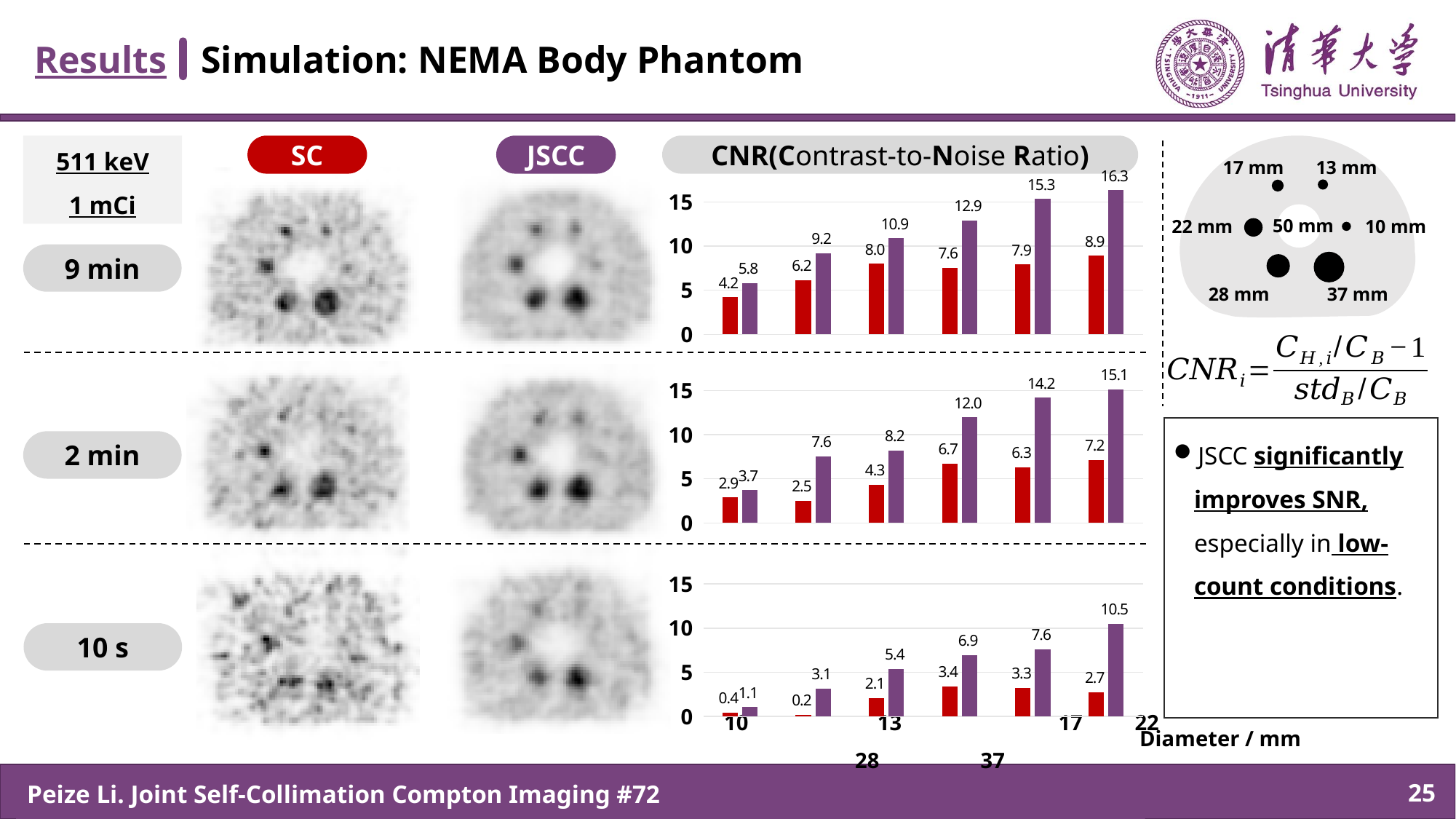
How many groups of bars does each CNR chart contain? 6 In the 9 min CNR chart, what is the difference between the JSCC and SC values in the rightmost group of bars? 7.4 In the 9 min CNR chart, what is the JSCC value for the rightmost group of bars? 16.3 In the 9 min CNR chart, do the JSCC values rise or fall from left to right? Rise In the 2 min CNR chart, which is larger in the rightmost group: the SC value or the JSCC value? JSCC (15.1) In the 2 min CNR chart, what is the lowest SC value shown? 2.5 What type of chart is used to show the CNR values? Bar chart In the 10 s CNR chart, which group of bars has the highest JSCC value? The rightmost group (10.5) In the 9 min CNR chart, what is the SC value for the leftmost group of bars? 4.2 In the 10 s CNR chart, what is the difference between the JSCC and SC values in the third group of bars from the left? 3.3 In the 10 s CNR chart, what is the SC value for the second group of bars from the left? 0.2 In the 2 min CNR chart, what is the JSCC value for the fourth group of bars from the left? 12.0